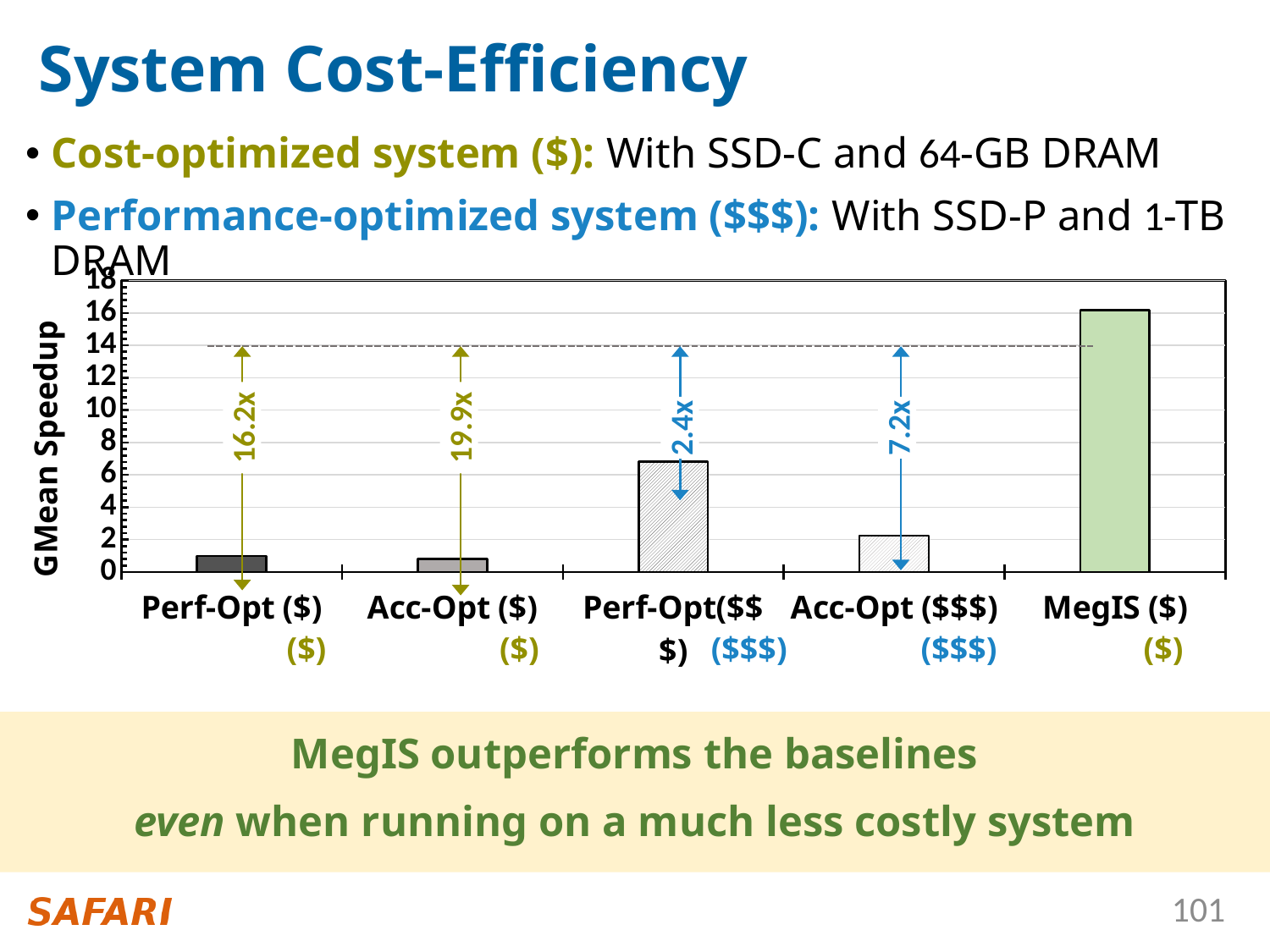
What kind of chart is shown on the slide? bar chart Is the GMean Speedup for Perf-Opt($$$) greater or less than 8? less Which has a higher GMean Speedup, Perf-Opt($$$) or Acc-Opt ($$$)? Perf-Opt($$$) Is the GMean Speedup for Acc-Opt ($$$) greater or less than 4? less Is the GMean Speedup for MegIS ($) greater or less than 14? greater How many categories are shown on the x axis of the chart? 5 What is the label of the y axis of the chart? GMean Speedup Which has a higher GMean Speedup, MegIS ($) or Perf-Opt($$$)? MegIS ($) Which category has the highest GMean Speedup? MegIS ($) What speedup factor is annotated on the arrow above Acc-Opt ($)? 19.9x What speedup factor is annotated on the arrow above Perf-Opt($$$)? 2.4x